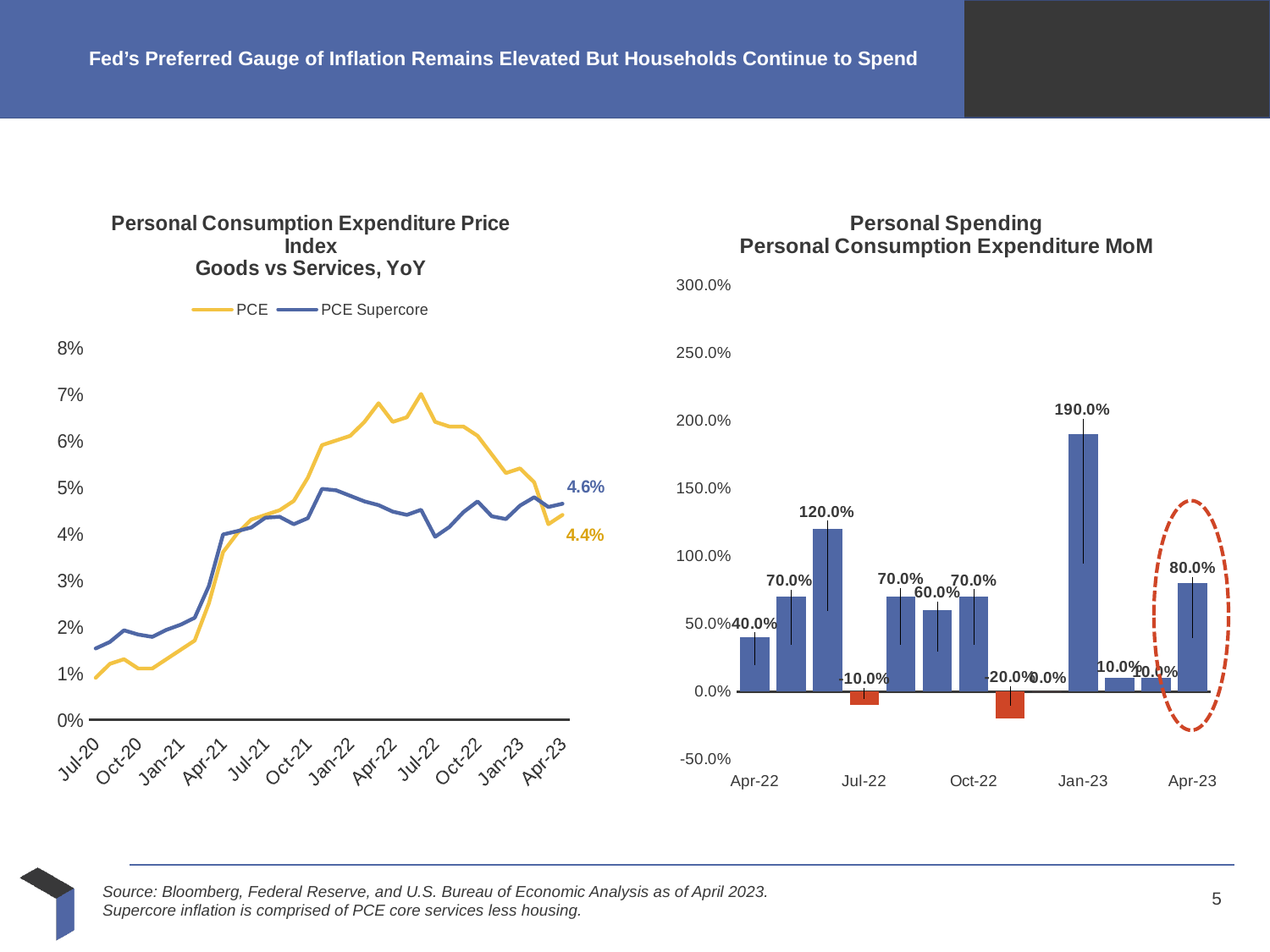
On the left chart (PCE Price Index, Goods vs Services), what is the final labelled value of the PCE Supercore line? 4.6% What kind of chart is the 'Personal Spending Personal Consumption Expenditure MoM' chart on the right? bar chart On the left chart (PCE Price Index, Goods vs Services), what is the difference between the final labelled values of PCE Supercore and PCE? 0.2% On the right chart (Personal Spending, PCE MoM), what is the difference between the Jan-23 bar and the Apr-23 bar? 110.0% On the left chart (PCE Price Index, Goods vs Services), which series ends higher at the last point, PCE or PCE Supercore? PCE Supercore On the left chart (PCE Price Index, Goods vs Services), what is the final labelled value of the PCE line? 4.4% How many series does the legend of the left chart (PCE Price Index, Goods vs Services) list? 2 On the right chart (Personal Spending, PCE MoM), what is the lowest labelled bar value? -20.0% On the right chart (Personal Spending, PCE MoM), which month has the highest bar? Jan-23 On the right chart (Personal Spending, PCE MoM), what is the value of the circled bar at Apr-23? 80.0% On the right chart (Personal Spending, PCE MoM), what is the value of the bar at Apr-22? 40.0% What kind of chart is the 'Personal Consumption Expenditure Price Index Goods vs Services, YoY' chart on the left? line chart